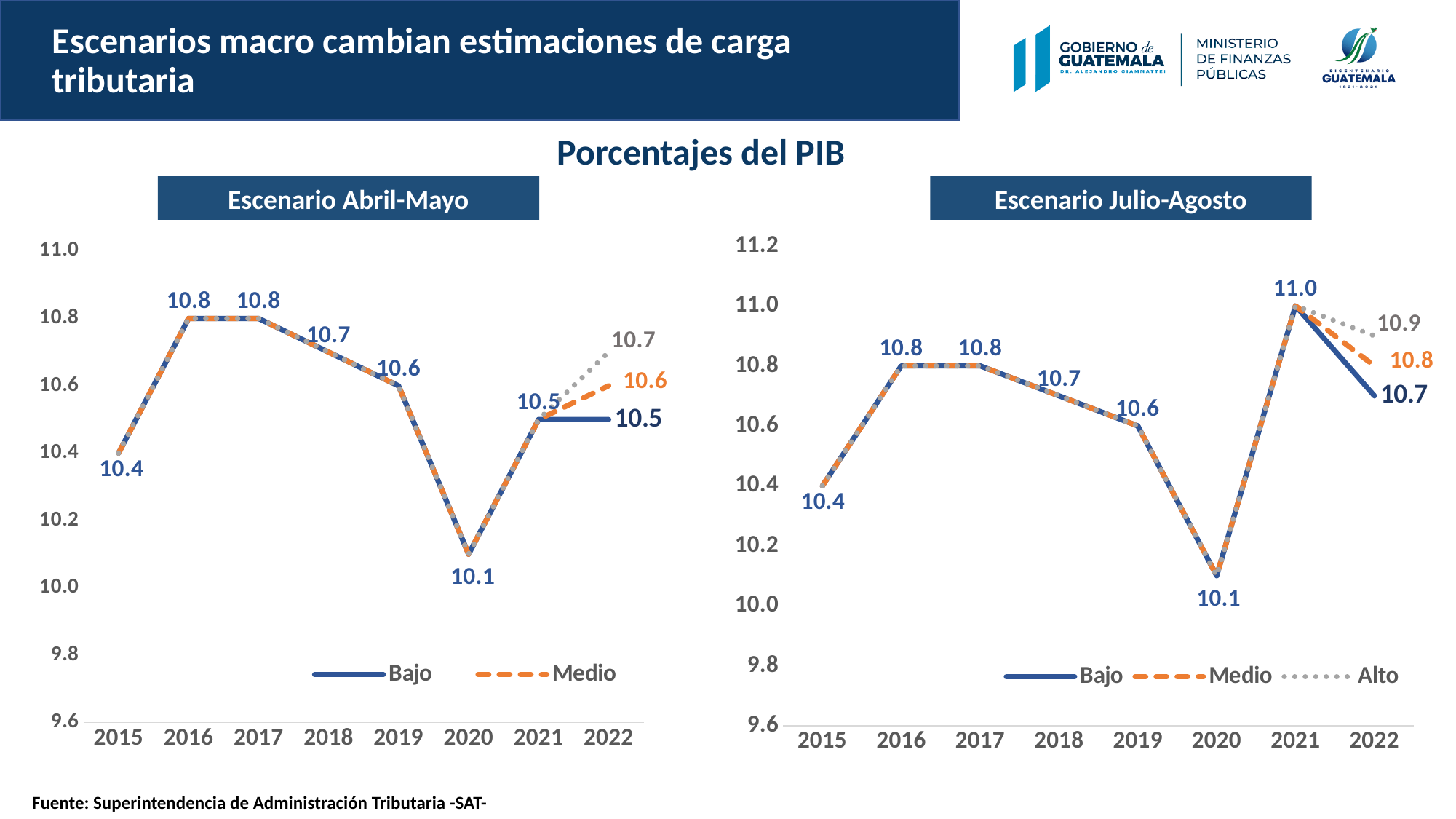
In the Escenario Julio-Agosto chart, is the 2022 Medio value larger or smaller than the 2022 Bajo value? larger In the Escenario Julio-Agosto chart, which year has the highest value? 2021 In the Escenario Abril-Mayo chart, what is the value for 2020? 10.1 In the Escenario Abril-Mayo chart, which year has the lowest value? 2020 In the Escenario Julio-Agosto chart, what is the value for 2021? 11.0 In the Escenario Julio-Agosto chart, what is the Bajo value for 2022? 10.7 In the Escenario Julio-Agosto chart, what is the Alto value for 2022? 10.9 In the Escenario Abril-Mayo chart, what is the difference between the Medio and Bajo values for 2022? 0.1 In the Escenario Julio-Agosto chart, what is the difference between the 2021 value and the 2020 value? 0.9 What type of chart is the Escenario Abril-Mayo chart? line chart How many series does the legend of the Escenario Julio-Agosto chart list? 3 In the Escenario Abril-Mayo chart, what is the Medio value for 2022? 10.6